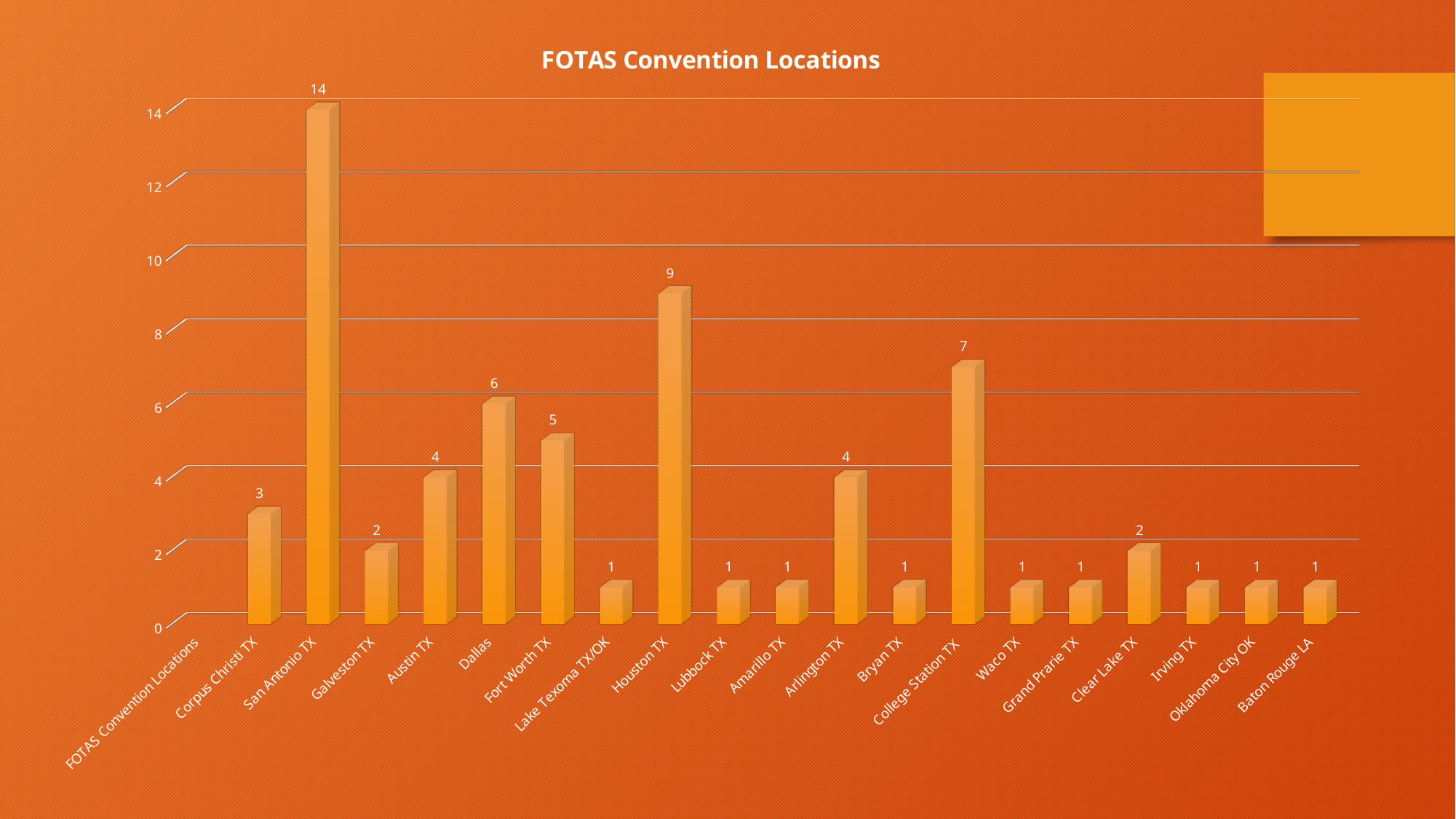
What kind of chart is shown on the slide? Bar chart What is the value for College Station TX? 7 What is the value for Clear Lake TX? 2 What is the title of the chart? FOTAS Convention Locations Which is larger, the value for Austin TX or the value for Corpus Christi TX? Austin TX What is the difference between the values for Fort Worth TX and Galveston TX? 3 What is the value for Houston TX? 9 Which location has the highest value? San Antonio TX What is the value for San Antonio TX? 14 Which is larger, the value for College Station TX or the value for Dallas? College Station TX What is the difference between the values for San Antonio TX and Houston TX? 5 What is the value for Dallas? 6